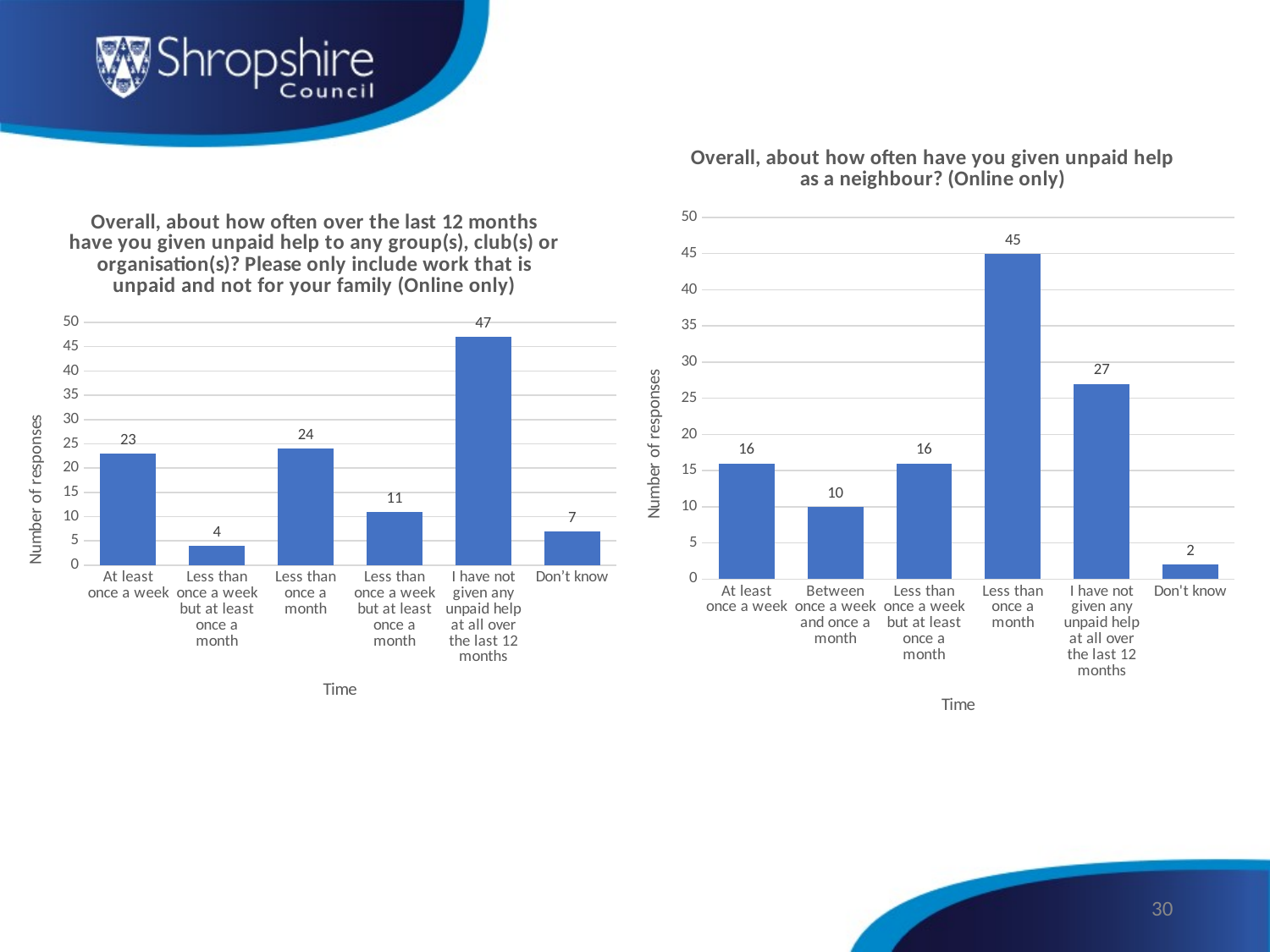
In the left chart about unpaid help to groups, clubs or organisations, which category has the lowest number of responses? Less than once a week but at least once a month In the right chart about unpaid help as a neighbour, which is larger: 'Between once a week and once a month' or 'I have not given any unpaid help at all over the last 12 months'? I have not given any unpaid help at all over the last 12 months In the right chart about unpaid help as a neighbour, which category has the lowest number of responses? Don't know In the right chart about unpaid help as a neighbour, how many responses are there for 'Less than once a month'? 45 In the left chart about unpaid help to groups, clubs or organisations, what is the difference between the 'Less than once a month' and 'Don't know' values? 17 What type of chart is the right chart about unpaid help as a neighbour? Bar chart What is the y-axis label of the left chart about unpaid help to groups, clubs or organisations? Number of responses In the right chart about unpaid help as a neighbour, how many responses are there for 'Don't know'? 2 In the left chart about unpaid help to groups, clubs or organisations, how many categories are shown on the x axis? 6 In the left chart about unpaid help to groups, clubs or organisations, which category has the highest number of responses? I have not given any unpaid help at all over the last 12 months In the right chart about unpaid help as a neighbour, what is the difference between the 'Less than once a month' and 'I have not given any unpaid help at all over the last 12 months' values? 18 In the left chart about unpaid help to groups, clubs or organisations, how many responses are there for 'At least once a week'? 23